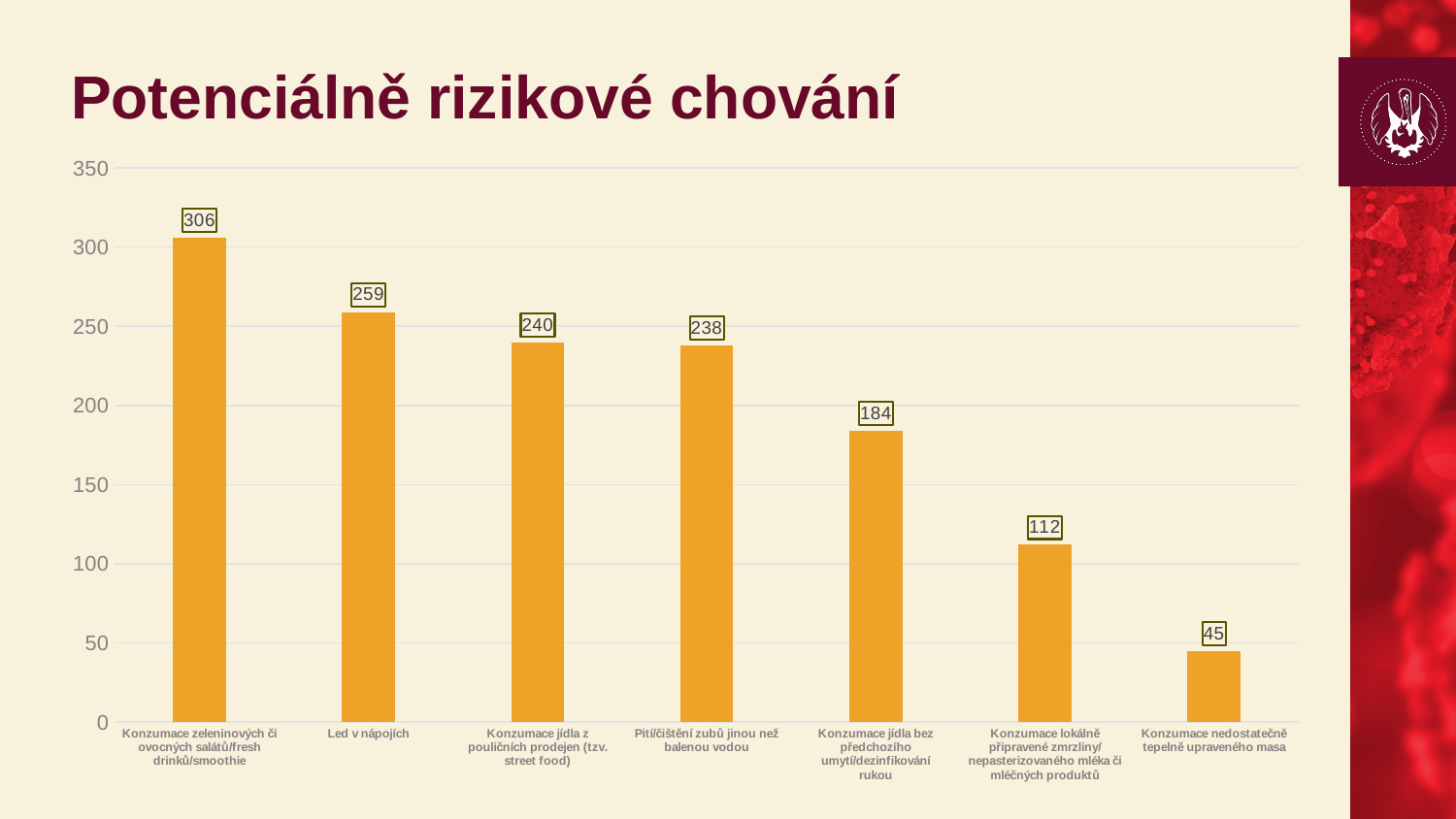
What is the value for "Led v nápojích"? 259 What is the difference between the values for "Konzumace jídla bez předchozího umytí/dezinfikování rukou" and "Konzumace lokálně připravené zmrzliny/nepasterizovaného mléka či mléčných produktů"? 72 What is the title of the slide? Potenciálně rizikové chování What is the difference between the values for "Konzumace zeleninových či ovocných salátů/fresh drinků/smoothie" and "Led v nápojích"? 47 Which is larger: the value for "Konzumace jídla z pouličních prodejen (tzv. street food)" or the value for "Pití/čištění zubů jinou než balenou vodou"? Konzumace jídla z pouličních prodejen (tzv. street food) What is the value for "Konzumace jídla bez předchozího umytí/dezinfikování rukou"? 184 Is the value for "Konzumace lokálně připravené zmrzliny/nepasterizovaného mléka či mléčných produktů" greater or less than 150? less What is the value for "Konzumace nedostatečně tepelně upraveného masa"? 45 Which category has the lowest value? Konzumace nedostatečně tepelně upraveného masa Which category has the highest value? Konzumace zeleninových či ovocných salátů/fresh drinků/smoothie How many categories are shown in the chart? 7 What kind of chart is shown on the slide? bar chart